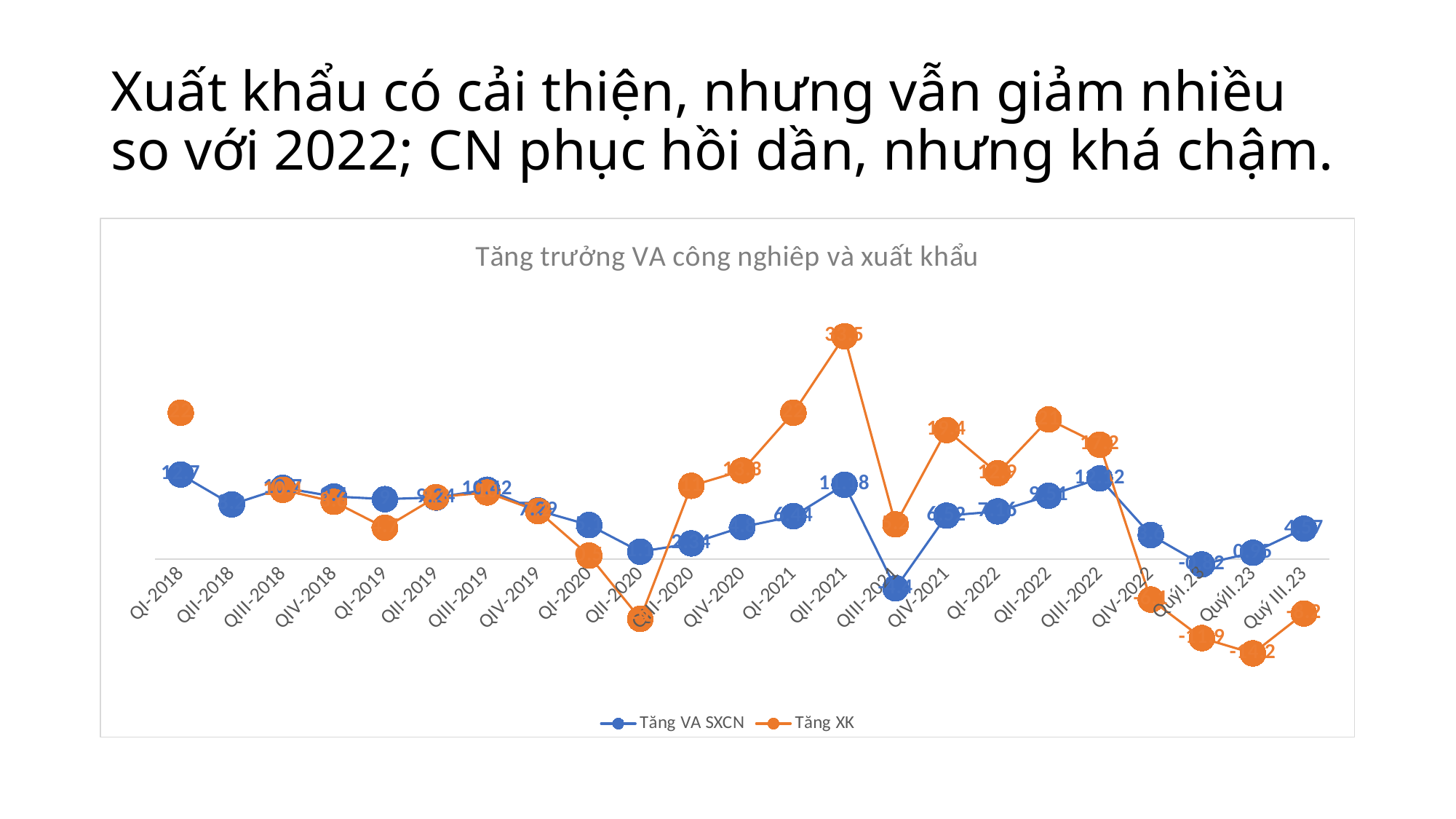
How many quarters are plotted along the x axis? 23 How many series does the legend list? 2 What are the two series named in the legend? Tăng VA SXCN and Tăng XK What kind of chart is shown on the slide? line chart Does the Tăng XK series rise or fall from QIII-2022 to QuýII.23? fall In which quarter does the Tăng XK series reach its lowest point? QuýII.23 At QIII-2021, which series has the larger value, Tăng VA SXCN or Tăng XK? Tăng XK For the Tăng XK series, which is larger: the value at QI-2022 or at QII-2022? QII-2022 In which quarter does the Tăng VA SXCN series reach its lowest point? QIII-2021 In which quarter does the Tăng XK series reach its highest point? QII-2021 At QII-2021, which series has the larger value, Tăng VA SXCN or Tăng XK? Tăng XK What is the title of the chart? Tăng trưởng VA công nghiêp và xuất khẩu